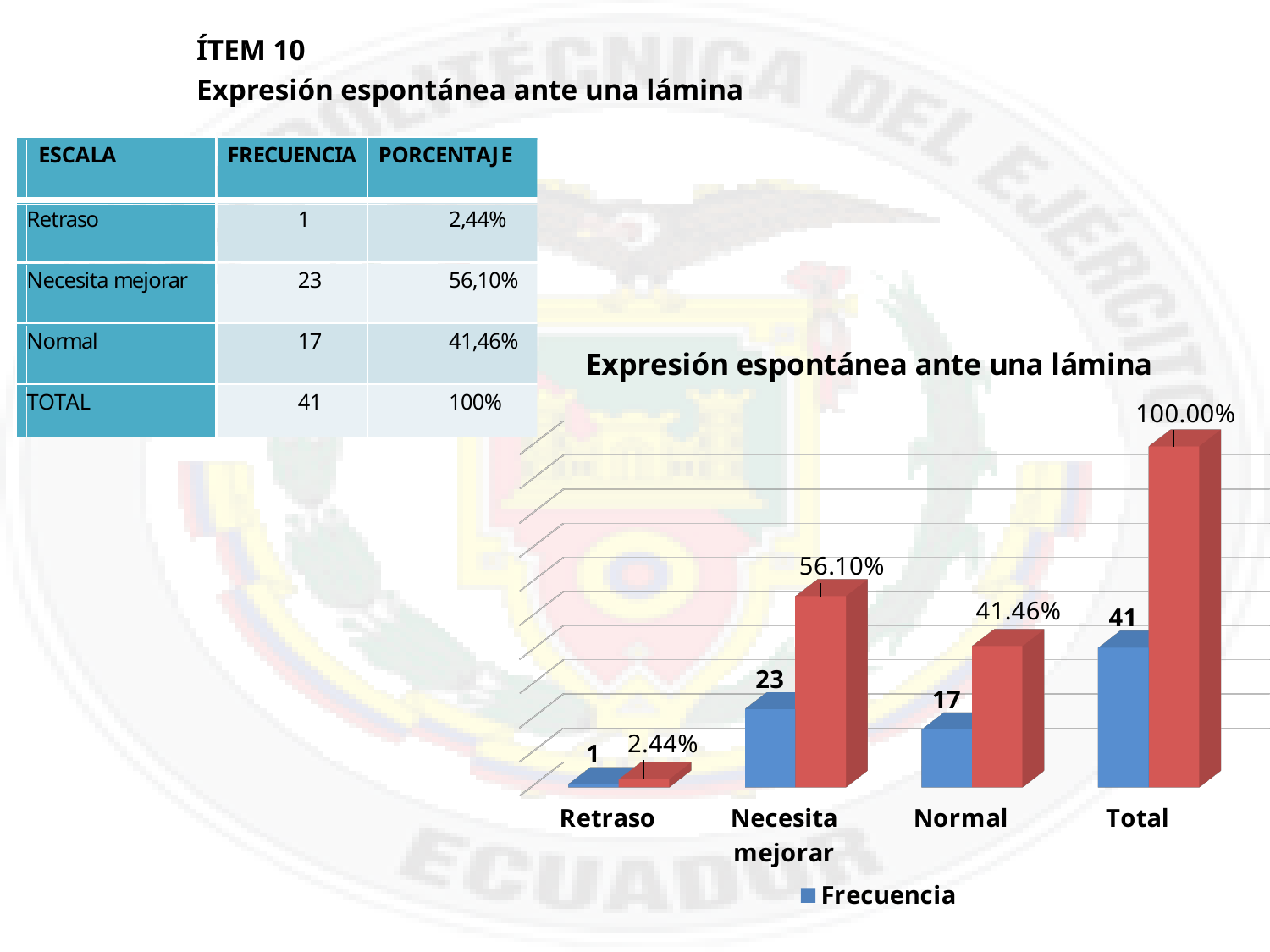
What is the difference between the percentage labels for Necesita mejorar and Normal? 14.64% What kind of chart is shown on the slide? Bar chart What percentage is labelled for Total in the chart? 100.00% What is the title of the chart? Expresión espontánea ante una lámina What percentage is labelled for Normal in the chart? 41.46% How many categories are shown on the x axis of the chart? 4 Which category has the lowest Frecuencia in the chart? Retraso What is the difference between the Frecuencia values for Necesita mejorar and Normal? 6 Which has a larger Frecuencia value, Normal or Retraso? Normal Excluding Total, which category has the highest Frecuencia in the chart? Necesita mejorar What is the Frecuencia value for Retraso in the chart? 1 What is the Frecuencia value for Necesita mejorar in the chart? 23